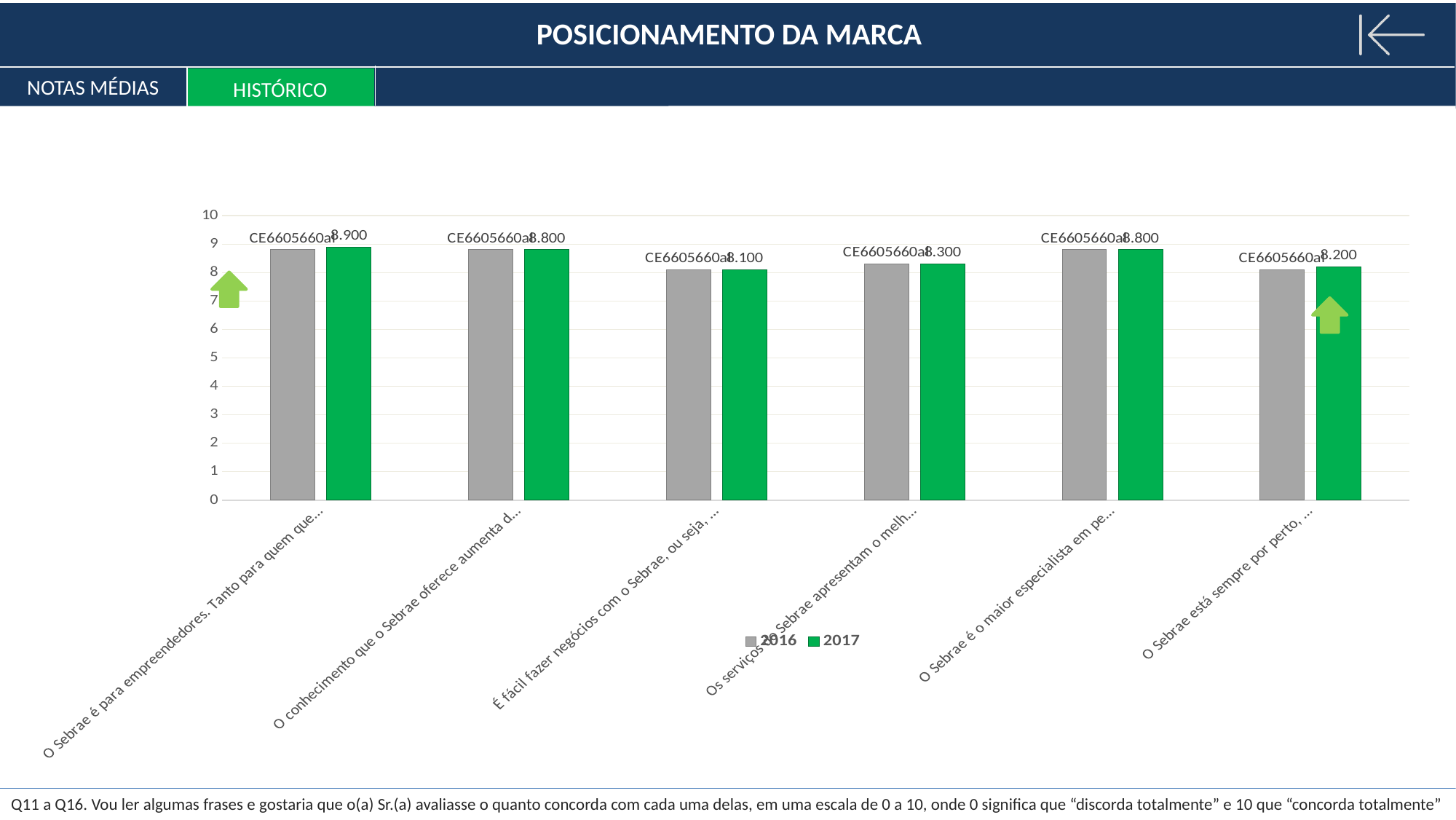
Which is larger in 2017: "Os serviços do Sebrae apresentam o melh..." or "O Sebrae está sempre por perto..."? Os serviços do Sebrae apresentam o melh... What is the 2017 value for "O Sebrae é para empreendedores..."? 8.900 How many series does the legend list? 2 Which category has the highest 2017 value? O Sebrae é para empreendedores... Which category has the lowest 2017 value? É fácil fazer negócios com o Sebrae... What is the difference between the highest and lowest 2017 values? 0.800 What is the 2017 value for "Os serviços do Sebrae apresentam o melh..."? 8.300 Is the 2016 value for "O Sebrae é o maior especialista em pe..." greater or less than 8? greater What kind of chart is shown on the slide? bar chart What is the 2017 value for "É fácil fazer negócios com o Sebrae..."? 8.100 What is the 2017 value for "O Sebrae está sempre por perto..."? 8.200 How many categories are shown on the x axis? 6